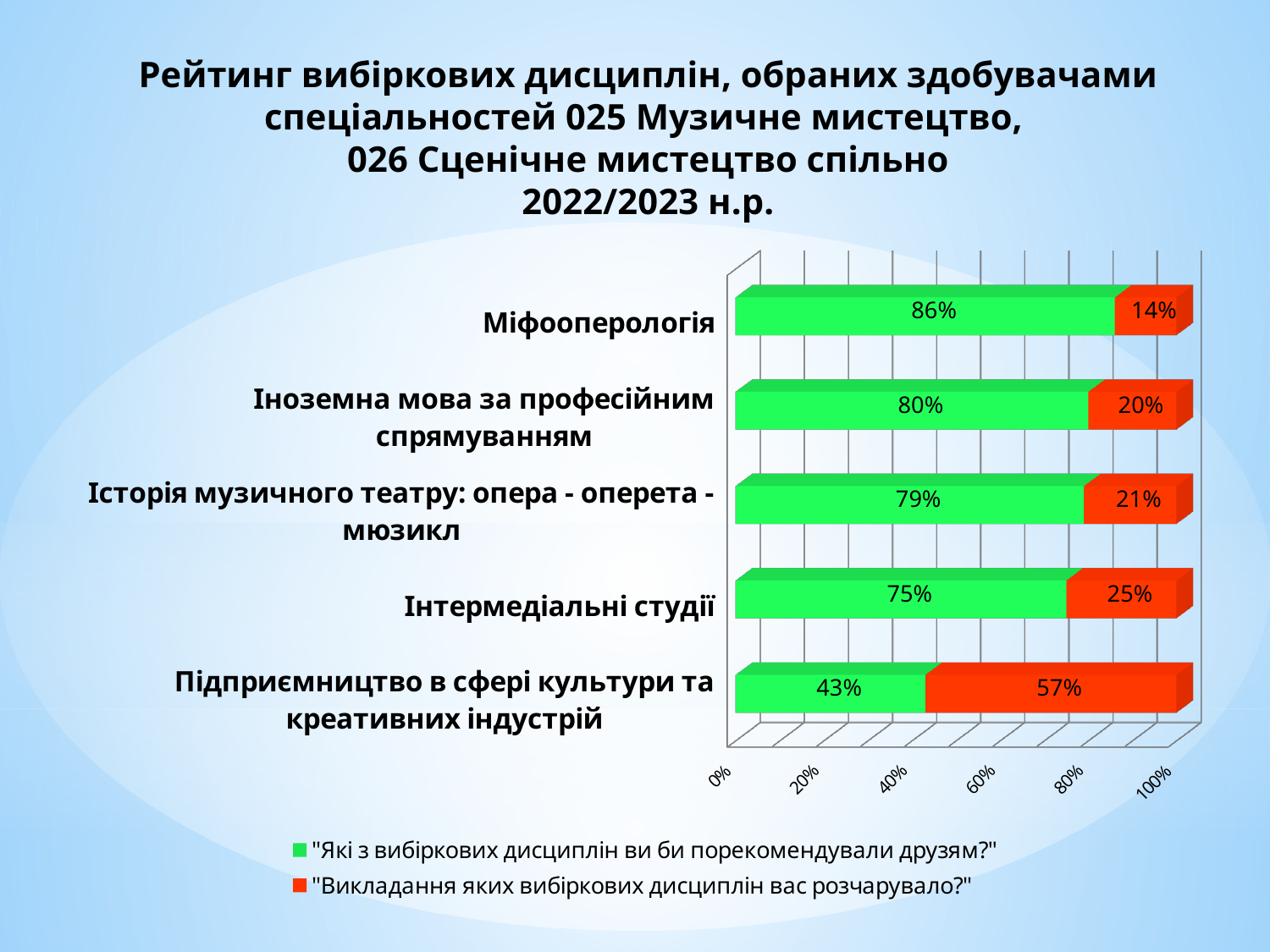
What is the red (disappointed) value for Підприємництво в сфері культури та креативних індустрій? 57% What is the difference between the green values for Іноземна мова за професійним спрямуванням and Інтермедіальні студії? 5% How many series does the legend list? 2 Which has a larger red (disappointed) value: Міфооперологія or Інтермедіальні студії? Інтермедіальні студії What percentage of respondents would recommend Міфооперологія to friends (green series)? 86% What is the total of the stacked bar for Історія музичного театру: опера - оперета - мюзикл? 100% Which discipline has the lowest green (recommend) value? Підприємництво в сфері культури та креативних індустрій What is the green (recommend) value for Інтермедіальні студії? 75% What kind of chart is shown on the slide? Stacked bar chart Which discipline has the highest green (recommend) value? Міфооперологія What colour represents the series "Викладання яких вибіркових дисциплін вас розчарувало?"? Red How many disciplines are shown on the chart? 5